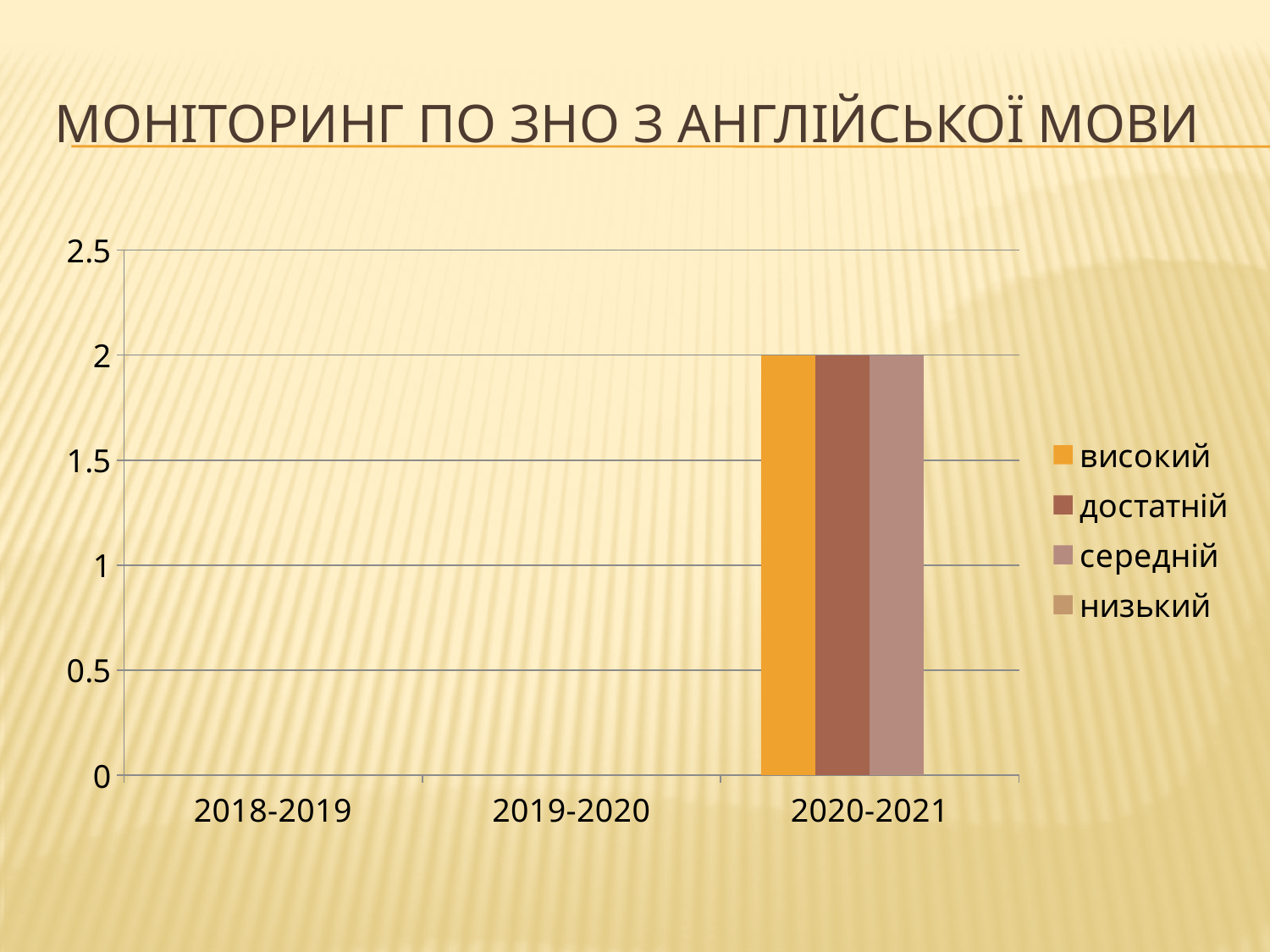
Is the value for високий in 2020-2021 greater or less than 1.5? greater What is the title of the chart? МОНІТОРИНГ ПО ЗНО З АНГЛІЙСЬКОЇ МОВИ Is the value for середній in 2020-2021 greater or less than 2.5? less Which legend entry is shown in orange? високий What kind of chart is shown on the slide? bar chart What is the difference between the values for високий and достатній in 2020-2021? 0 What is the value for високий in 2020-2021? 2 How many categories are shown on the x axis? 3 What is the value for достатній in 2020-2021? 2 What is the value for середній in 2020-2021? 2 Which category on the x axis has visible bars? 2020-2021 How many series does the legend list? 4